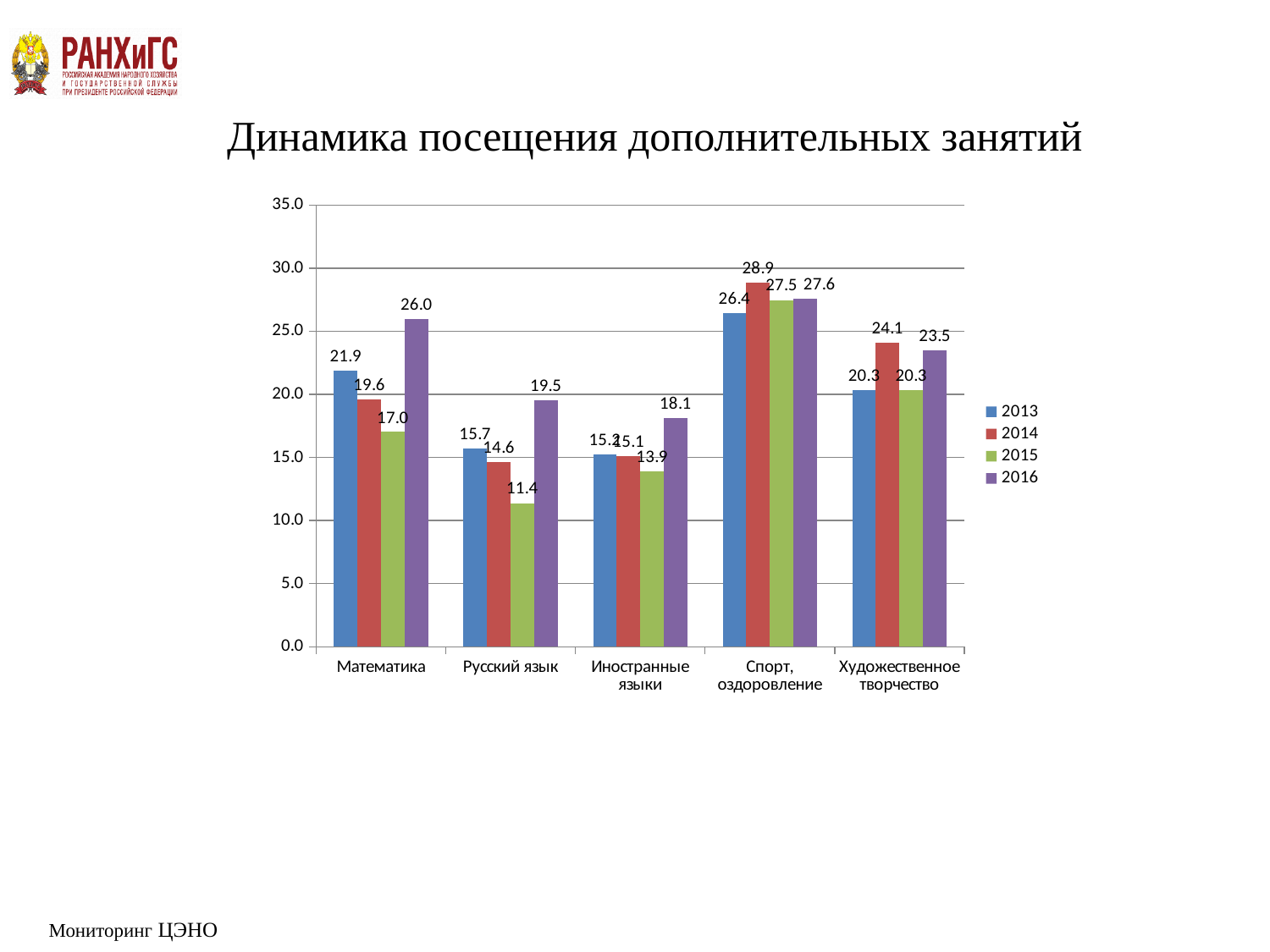
Which category has the lowest value in 2015? Русский язык What is the value for Русский язык in 2015? 11.4 How many series does the legend list? 4 What is the difference between the 2016 and 2015 values for Математика? 9.0 What is the value for Спорт, оздоровление in 2014? 28.9 What kind of chart is shown on the slide? bar chart How many categories are shown on the x axis? 5 What is the value for Математика in 2016? 26.0 Which is larger for Иностранные языки: the 2016 value or the 2015 value? 2016 What is the value for Художественное творчество in 2014? 24.1 Which category has the highest value in 2013? Спорт, оздоровление What is the title of the chart? Динамика посещения дополнительных занятий